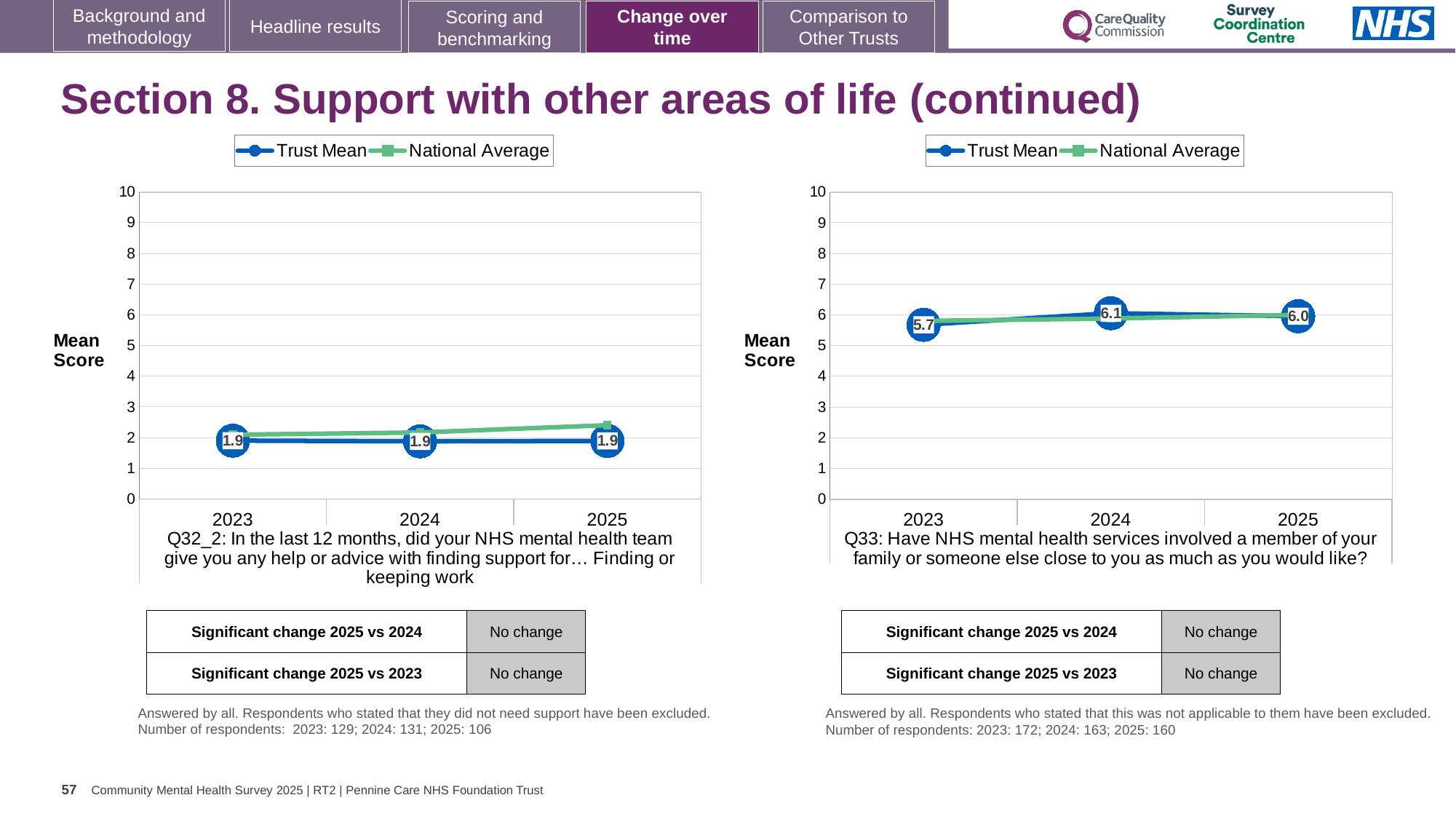
In the right chart (Q33), what is the Trust Mean for 2024? 6.1 In the right chart (Q33), which year has the highest Trust Mean? 2024 In the right chart (Q33), which year has the lowest Trust Mean? 2023 How many years are plotted on the x axis of the left chart (Q32_2)? 3 In the left chart (Q32_2), what is the Trust Mean for 2025? 1.9 In the left chart (Q32_2), does the Trust Mean rise, fall or stay flat from 2023 to 2025? stays flat In the left chart (Q32_2), is the National Average for 2025 greater or less than 2? greater In the right chart (Q33), what is the difference between the Trust Mean for 2024 and 2023? 0.4 What kind of chart is the left chart (Q32_2)? line chart In the right chart (Q33), what is the Trust Mean for 2023? 5.7 In the right chart (Q33), is the Trust Mean for 2025 larger or smaller than the Trust Mean for 2023? larger How many series does the legend of the right chart (Q33) list? 2